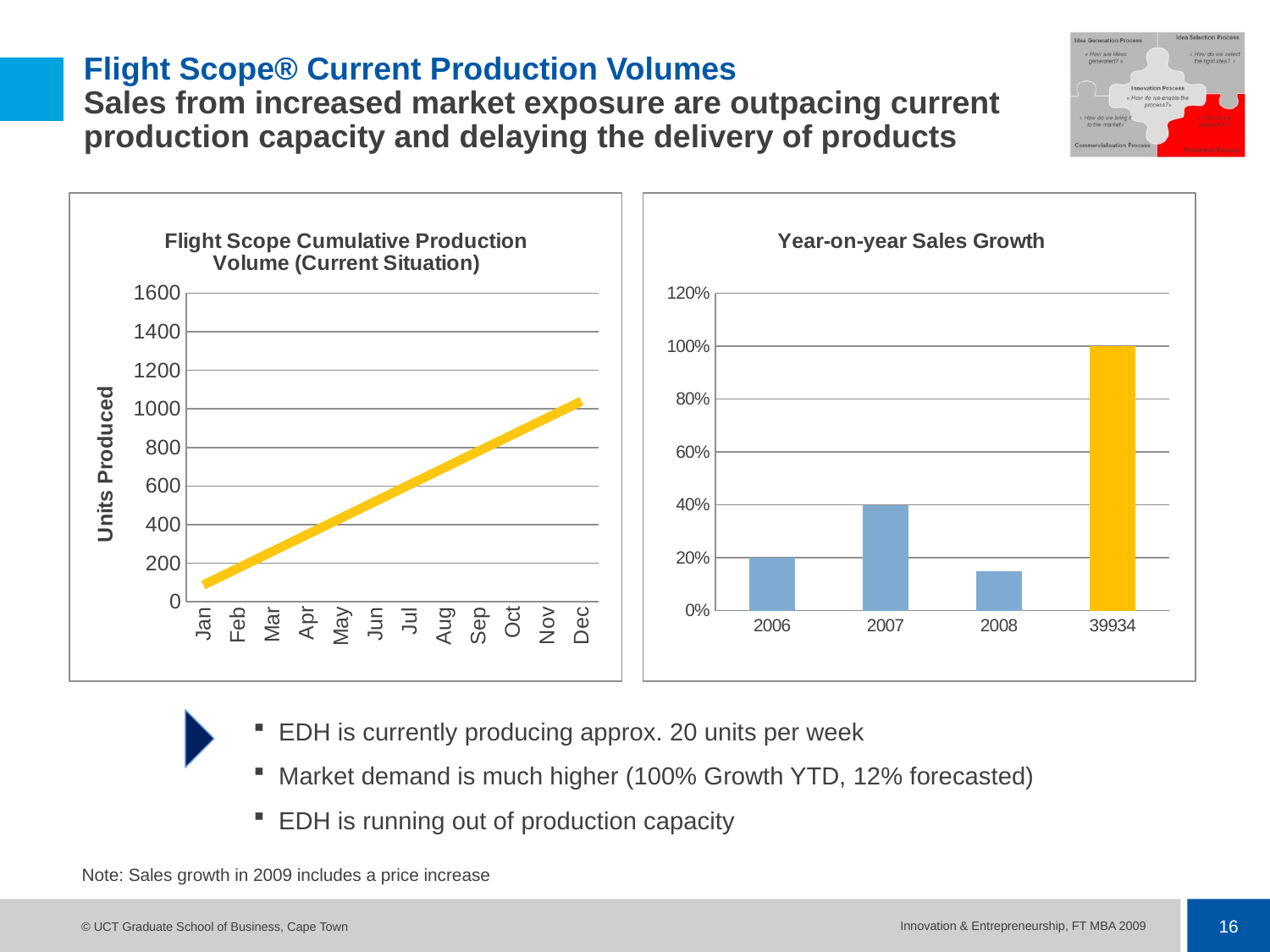
In the 'Year-on-year Sales Growth' chart, is the value for 2008 greater or less than 20%? less What kind of chart is the 'Flight Scope Cumulative Production Volume (Current Situation)' chart on the left? line chart In the 'Flight Scope Cumulative Production Volume (Current Situation)' chart, do the values rise or fall from Jan to Dec? rise In the 'Year-on-year Sales Growth' chart, how many categories are shown on the x axis? 4 What kind of chart is the 'Year-on-year Sales Growth' chart on the right? bar chart In the 'Flight Scope Cumulative Production Volume (Current Situation)' chart, is the value for Dec greater or less than 1000? greater In the 'Year-on-year Sales Growth' chart, which is larger, the value for 2007 or the value for 2008? 2007 In the 'Year-on-year Sales Growth' chart, which category has the highest value? 39934 In the 'Year-on-year Sales Growth' chart, what is the value for 39934? 100% In the 'Year-on-year Sales Growth' chart, what is the value for 2006? 20% In the 'Year-on-year Sales Growth' chart, what is the value for 2007? 40% In the 'Year-on-year Sales Growth' chart, which category has the lowest value? 2008